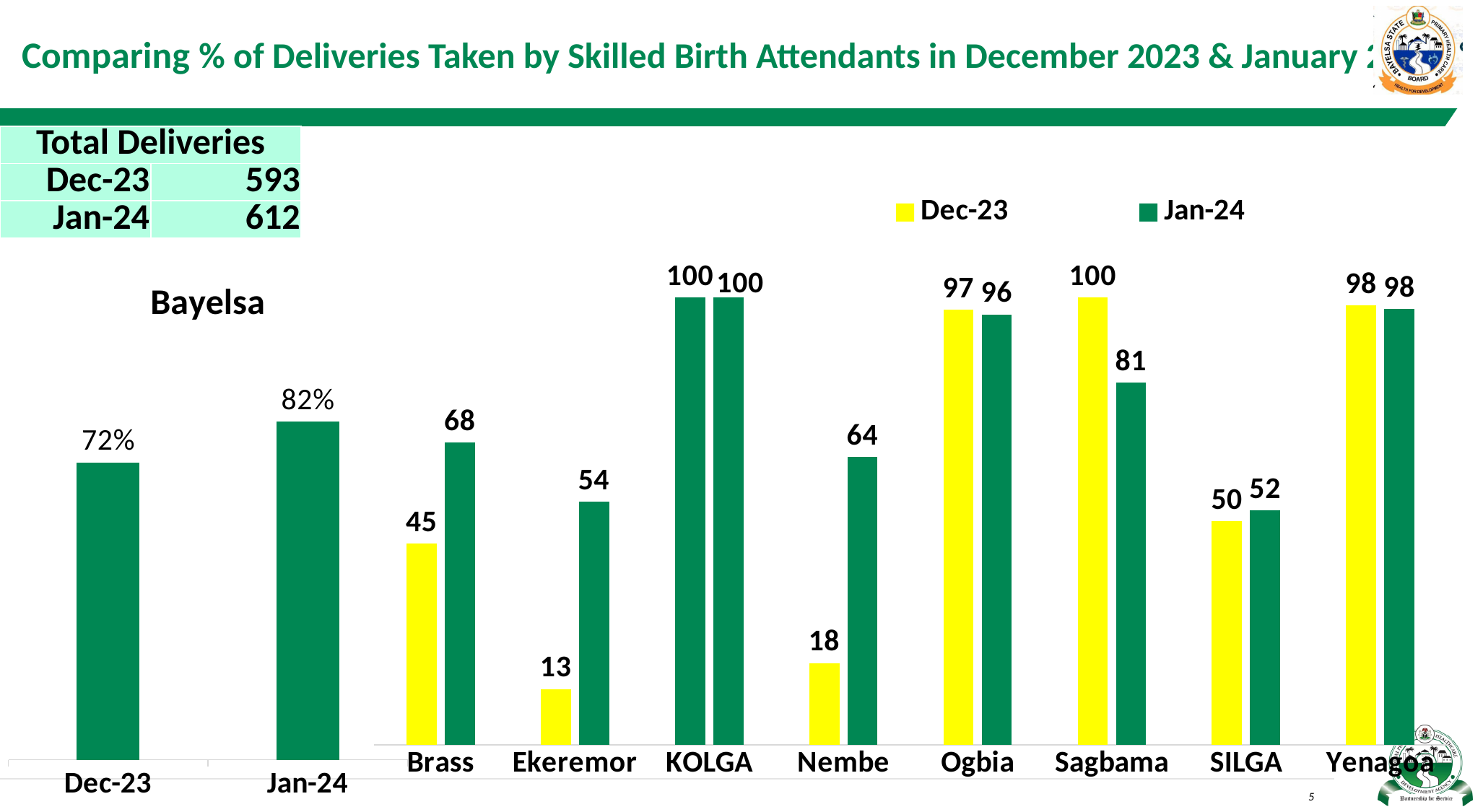
In the LGA chart on the right, which LGA has the lowest Dec-23 value? Ekeremor In the LGA chart on the right, what is the Dec-23 value for Ekeremor? 13 How many LGAs are shown in the chart on the right? 8 What type of chart is used on the right side of the slide? Bar chart In the LGA chart on the right, which LGA has the lowest Jan-24 value? SILGA How many series does the legend of the chart on the right list? 2 In the Bayelsa chart on the left, by how much did the value change from Dec-23 to Jan-24? 10 percentage points In the Bayelsa chart on the left, what is the value for Dec-23? 72% In the LGA chart on the right, what is the Jan-24 value for Nembe? 64 In the LGA chart on the right, is the Dec-23 value for Brass larger or smaller than its Jan-24 value? smaller In the LGA chart on the right, what is the difference between the Dec-23 and Jan-24 values for Sagbama? 19 In the Bayelsa chart on the left, what is the value for Jan-24? 82%